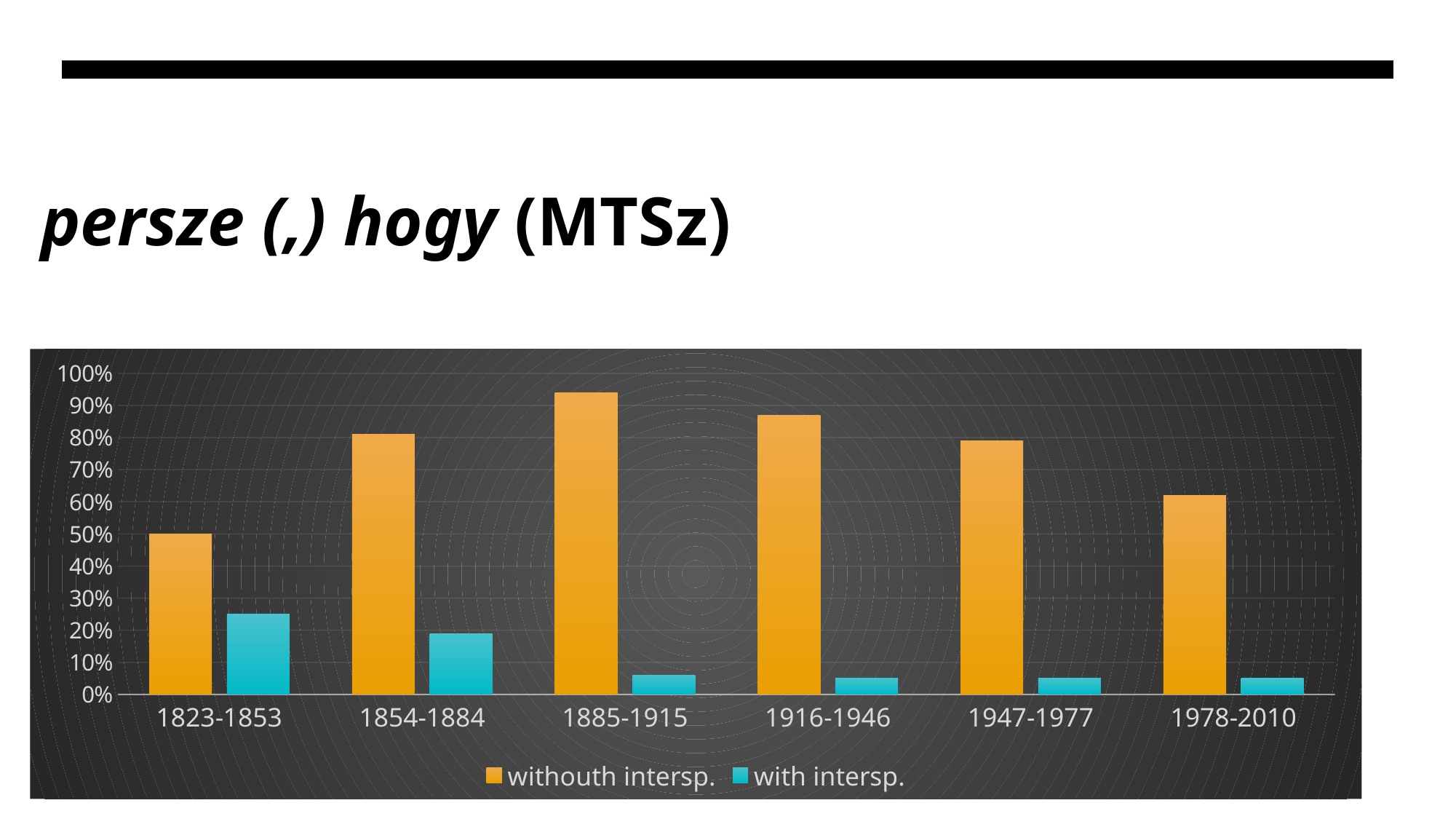
What colour are the bars for the 'with intersp.' series? cyan (light blue) Which period has the lowest value for the 'withouth intersp.' series? 1823-1853 Is the 'with intersp.' value for 1947-1977 greater or less than 10%? less Which period has the highest value for the 'withouth intersp.' series? 1885-1915 What kind of chart is shown on the slide? bar chart Which period has the larger 'with intersp.' value: 1823-1853 or 1854-1884? 1823-1853 Which period has the highest value for the 'with intersp.' series? 1823-1853 Which is larger for 1916-1946: the 'withouth intersp.' value or the 'with intersp.' value? withouth intersp. Is the 'withouth intersp.' value for 1978-2010 greater or less than 70%? less How many time periods are shown on the x axis of the chart? 6 Is the 'withouth intersp.' value for 1885-1915 greater or less than 90%? greater How many series does the chart's legend list? 2